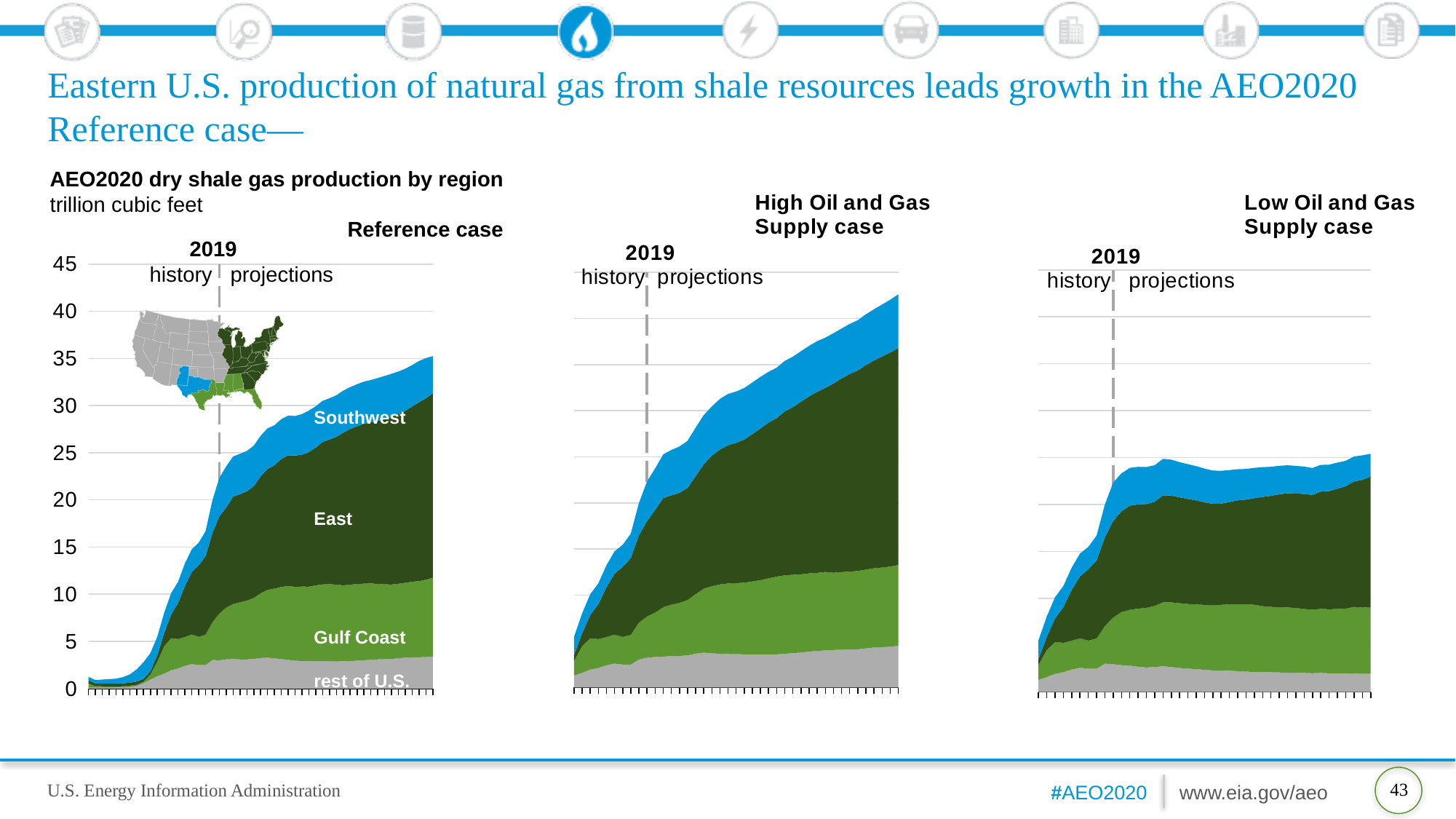
In the Reference case chart, which region contributes the smallest share of production at the end of the projection period? rest of U.S. How many regions are stacked in the Reference case chart? 4 What unit of measurement is used for the charts? trillion cubic feet In the High Oil and Gas Supply case chart, is total production at the end of the projection period greater or less than 40 trillion cubic feet? greater In the Low Oil and Gas Supply case chart, is total production at the end of the projection period greater or less than 30 trillion cubic feet? less In the Reference case chart, does total production rise or fall over the projection period? rise What year does the dashed line separating history from projections mark? 2019 In the Reference case chart, which region contributes the largest share of production at the end of the projection period? East In the High Oil and Gas Supply case chart, does total production rise or fall over the projection period? rise In the Reference case chart, is total dry shale gas production at the end of the projection period greater or less than 30 trillion cubic feet? greater What kind of chart is the Reference case chart? stacked area chart Which chart shows higher total production at the end of the projection period, the High Oil and Gas Supply case or the Low Oil and Gas Supply case? High Oil and Gas Supply case